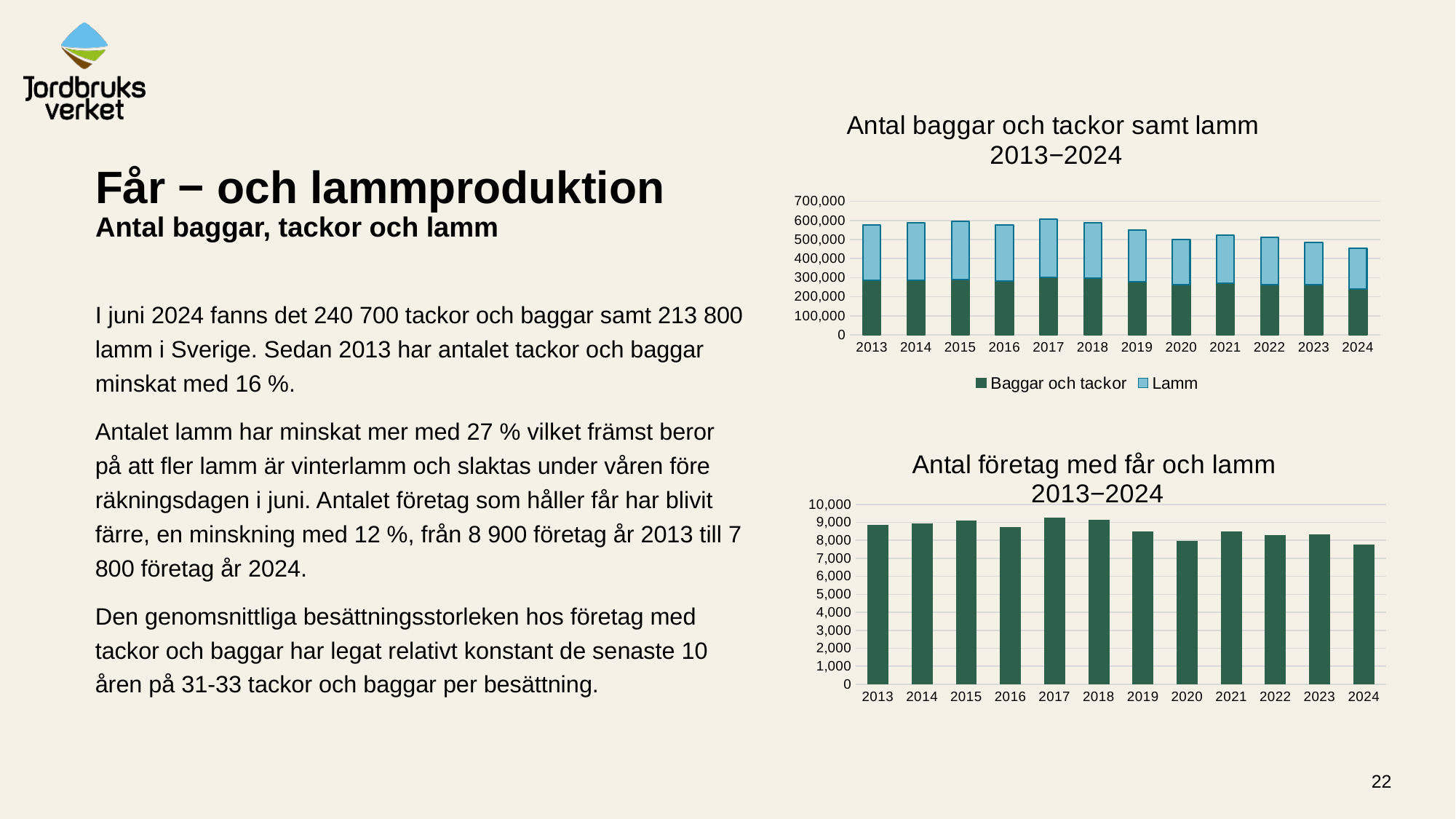
In the top chart "Antal baggar och tackor samt lamm 2013−2024", what are the two legend entries? Baggar och tackor; Lamm In the top chart "Antal baggar och tackor samt lamm 2013−2024", how many series does the legend list? 2 In the top chart "Antal baggar och tackor samt lamm 2013−2024", which year has the lowest total bar? 2024 What kind of chart is the top chart titled "Antal baggar och tackor samt lamm 2013−2024"? stacked bar chart In the top chart "Antal baggar och tackor samt lamm 2013−2024", is the total for 2024 greater or less than 500,000? less In the bottom chart "Antal företag med får och lamm 2013−2024", is the value for 2024 greater or less than 8,000? less In the top chart "Antal baggar och tackor samt lamm 2013−2024", is the Baggar och tackor value for 2024 greater or less than 300,000? less In the bottom chart "Antal företag med får och lamm 2013−2024", which is larger, the value for 2013 or the value for 2024? 2013 What kind of chart is the bottom chart titled "Antal företag med får och lamm 2013−2024"? bar chart How many years are shown on the x axis of the bottom chart "Antal företag med får och lamm 2013−2024"? 12 In the bottom chart "Antal företag med får och lamm 2013−2024", do the values overall rise or fall from 2013 to 2024? fall In the top chart "Antal baggar och tackor samt lamm 2013−2024", which year has the highest total bar? 2017